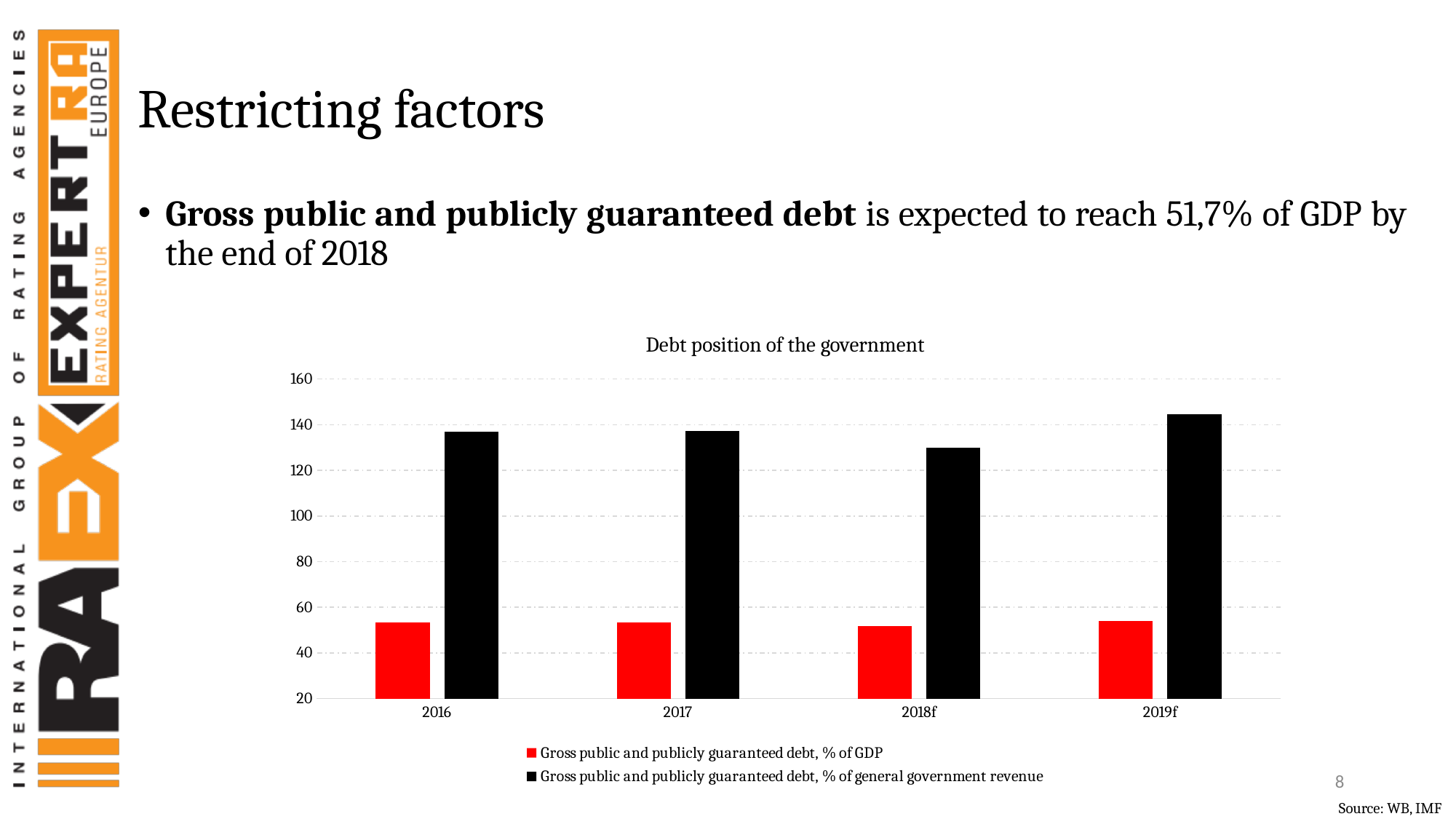
Which colour represents gross public and publicly guaranteed debt as % of GDP? red How many series does the legend list? 2 Which is larger: gross public and publicly guaranteed debt as % of general government revenue in 2019f or in 2018f? 2019f What kind of chart is shown on the slide? bar chart What is the title of the chart? Debt position of the government Is the value for gross public and publicly guaranteed debt as % of general government revenue in 2018f greater or less than 140? less How many years (categories) are shown on the x axis? 4 Which year has the highest value for gross public and publicly guaranteed debt as % of general government revenue? 2019f Which year has the lowest value for gross public and publicly guaranteed debt as % of general government revenue? 2018f Is the value for gross public and publicly guaranteed debt as % of GDP in 2018f greater or less than 40? greater Is the value for gross public and publicly guaranteed debt as % of GDP in 2016 greater or less than 60? less